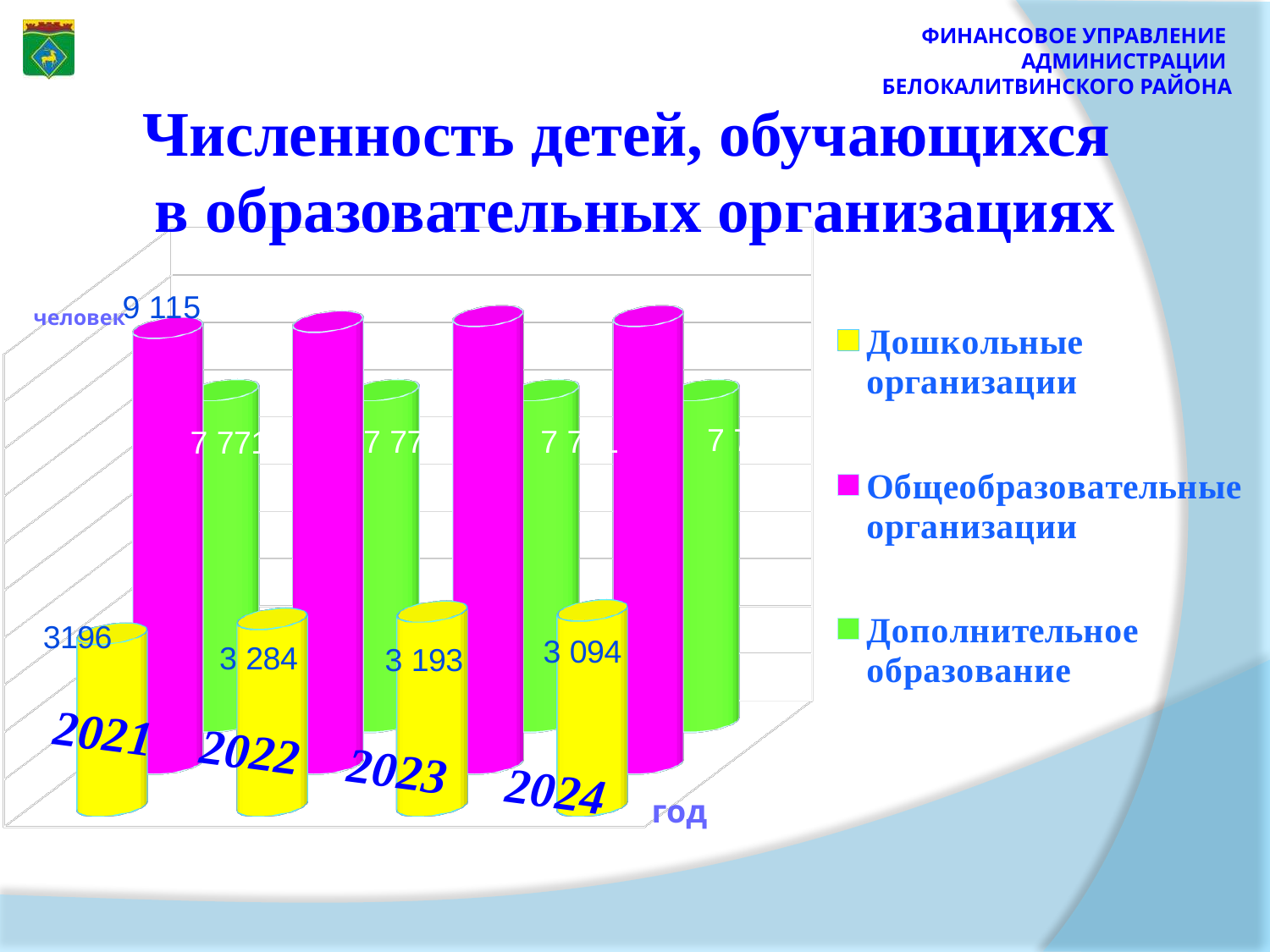
Do the values for Дошкольные организации rise or fall from 2022 to 2024? fall What kind of chart is shown on the slide? bar chart In which year is the value for Дошкольные организации the highest? 2022 In which year is the value for Дошкольные организации the lowest? 2024 What is the value for Дополнительное образование in 2021? 7 771 What is the value for Общеобразовательные организации in 2021? 9 115 What is the difference between the Дошкольные организации values for 2022 and 2024? 190 In 2021, which is larger: Общеобразовательные организации or Дополнительное образование? Общеобразовательные организации What is the value for Дошкольные организации in 2024? 3 094 How many series does the legend list? 3 How many years are shown on the x axis? 4 What is the value for Дошкольные организации in 2022? 3 284